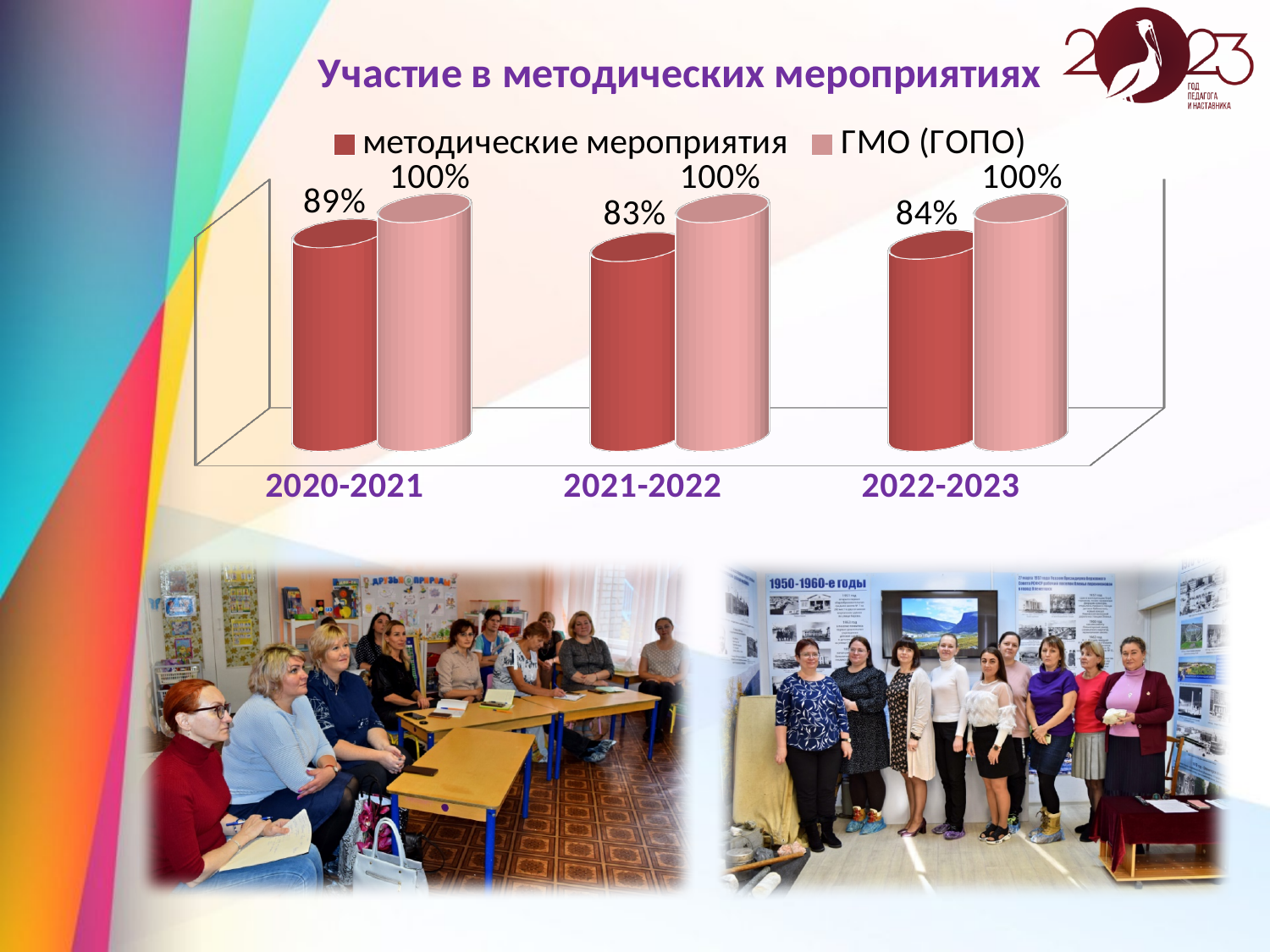
Which is larger in 2022-2023: методические мероприятия or ГМО (ГОПО)? ГМО (ГОПО) What is the difference between ГМО (ГОПО) and методические мероприятия in 2020-2021? 11% How many periods are shown on the x axis? 3 How many series does the legend list? 2 In which period is the value for методические мероприятия the lowest? 2021-2022 What is the value for методические мероприятия in 2020-2021? 89% What kind of chart is shown on the slide? Bar chart What is the difference between ГМО (ГОПО) and методические мероприятия in 2021-2022? 17% In which period is the value for методические мероприятия the highest? 2020-2021 What is the value for методические мероприятия in 2021-2022? 83% What is the value for ГМО (ГОПО) in 2021-2022? 100% What is the value for методические мероприятия in 2022-2023? 84%